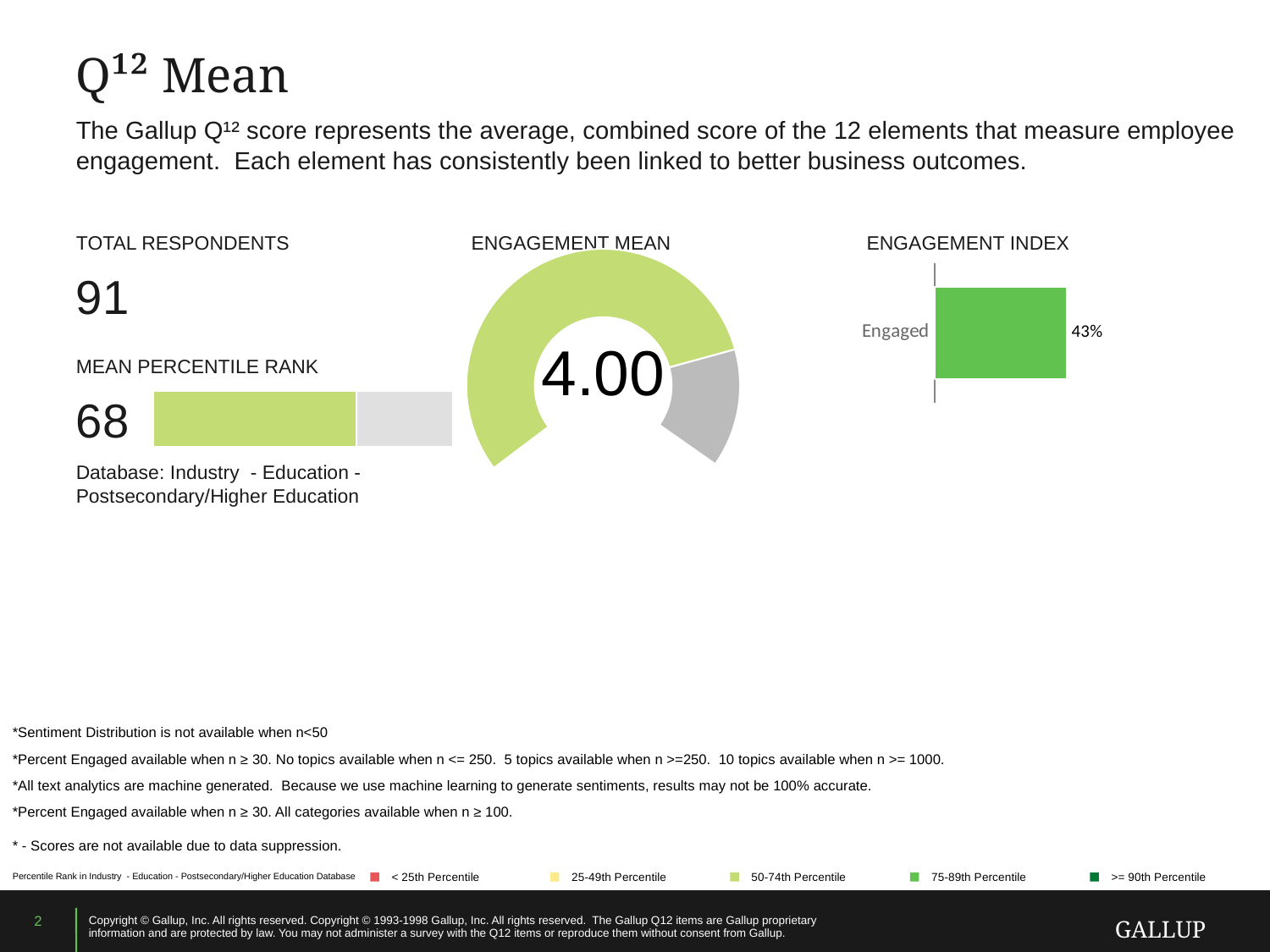
Which database is the Mean Percentile Rank compared against? Industry - Education - Postsecondary/Higher Education How many categories are plotted on the Engagement Index chart? 1 What value is shown in the centre of the Engagement Mean gauge? 4.00 What is the Mean Percentile Rank shown on the slide? 68 What kind of chart is the Engagement Mean chart? gauge chart What kind of chart is the Engagement Index chart? bar chart What is the Total Respondents figure shown on the slide? 91 What is the label of the single bar on the Engagement Index chart? Engaged Is the Engaged value on the Engagement Index chart greater or less than 50%? less Is the Mean Percentile Rank greater or less than 50? greater On the Engagement Index chart, what is the value for Engaged? 43%